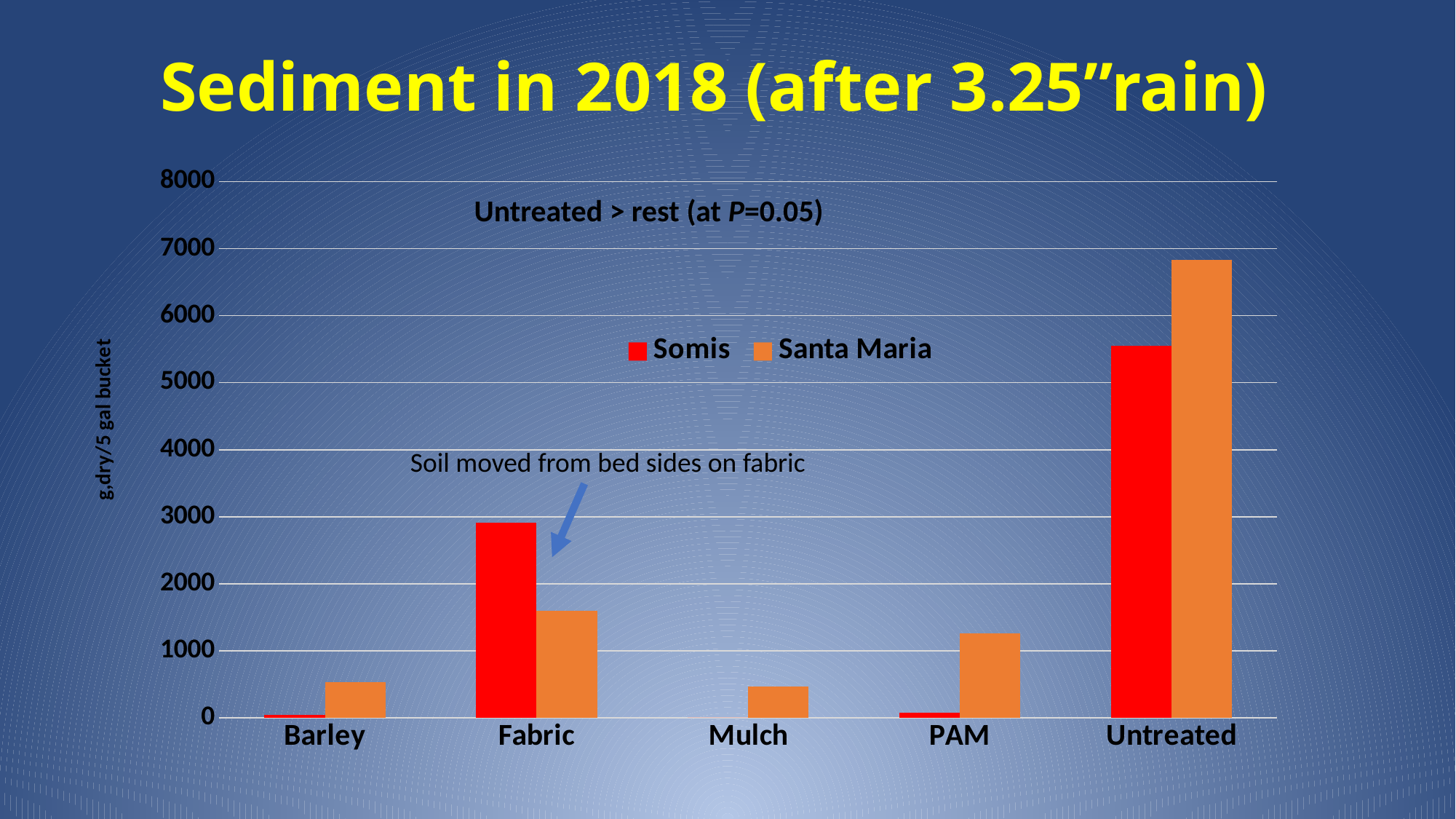
Is the Santa Maria value for PAM greater or less than 1000? greater What is the label on the y axis of the chart? g,dry/5 gal bucket What kind of chart is shown on the slide? bar chart How many treatment categories are shown on the x axis? 5 For Fabric, which series has the larger value, Somis or Santa Maria? Somis Is the Somis value for Fabric greater or less than 2000? greater Which category has the highest Somis value? Untreated For Untreated, which series has the larger value, Somis or Santa Maria? Santa Maria Which category has the highest Santa Maria value? Untreated Is the Somis value for Untreated greater or less than 5000? greater How many series does the legend list? 2